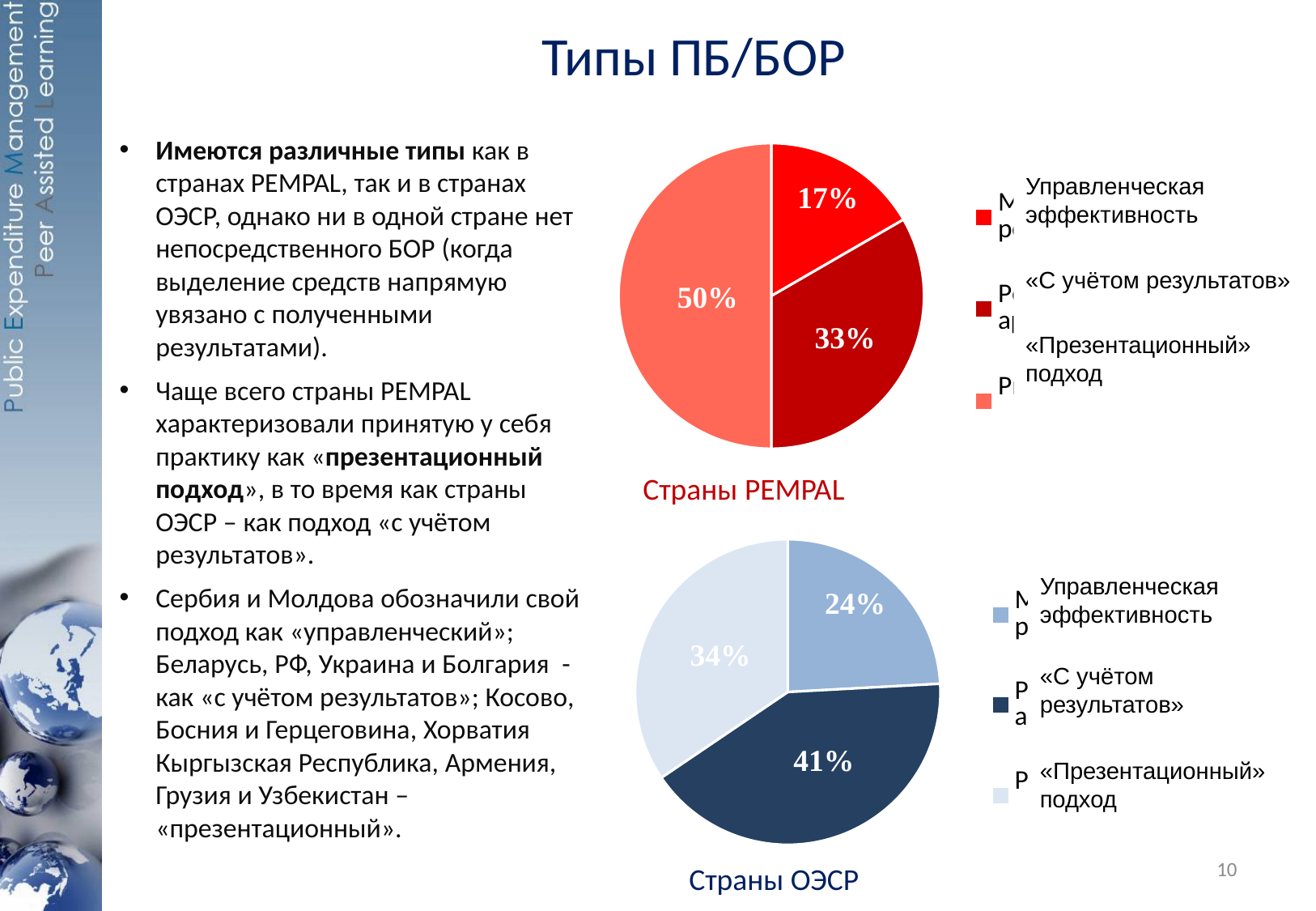
На диаграмме «Страны ОЭСР» какая доля приходится на подход «С учётом результатов»? 41% На диаграмме «Страны ОЭСР» что больше: доля подхода «С учётом результатов» или доля «Презентационного» подхода? «С учётом результатов» На диаграмме «Страны PEMPAL» какая категория имеет наибольшую долю? «Презентационный» подход На диаграмме «Страны PEMPAL» какая доля приходится на подход «С учётом результатов»? 33% На диаграмме «Страны ОЭСР» какая доля приходится на «Презентационный» подход? 34% На диаграмме «Страны PEMPAL» на сколько процентных пунктов доля «Презентационного» подхода больше доли «Управленческой эффективности»? 33% На диаграмме «Страны PEMPAL» какая доля приходится на «Управленческую эффективность»? 17% На диаграмме «Страны ОЭСР» какая категория имеет наименьшую долю? Управленческая эффективность На диаграмме «Страны ОЭСР» какая доля приходится на «Управленческую эффективность»? 24% Какого типа диаграмма «Страны ОЭСР»? Круговая диаграмма Сколько категорий перечислено в легенде диаграммы «Страны PEMPAL»? 3 На диаграмме «Страны PEMPAL» какая доля приходится на «Презентационный» подход? 50%